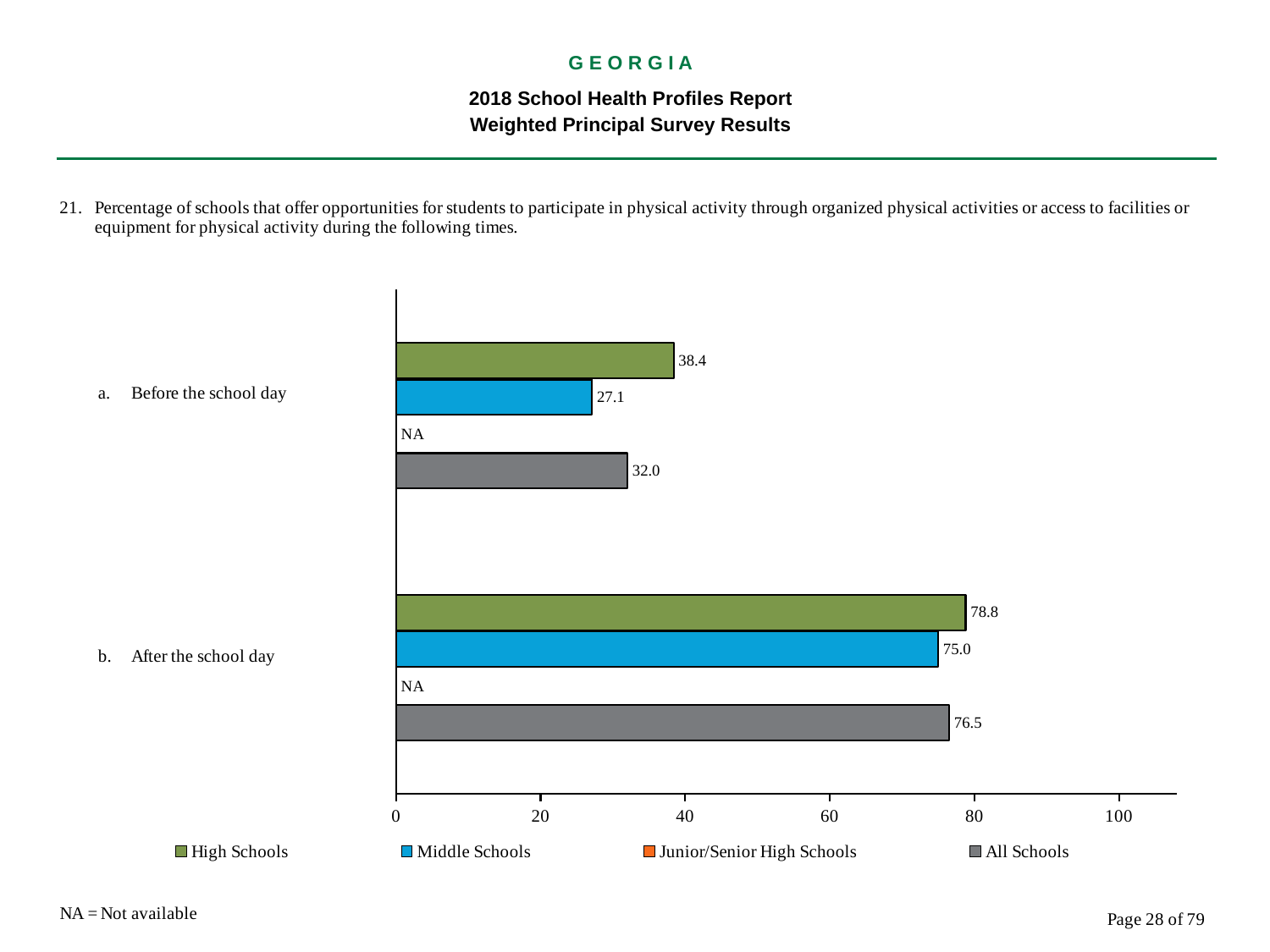
How many series does the legend list? 4 Which is larger for All Schools: 'Before the school day' or 'After the school day'? After the school day What is shown for Junior/Senior High Schools for 'After the school day'? NA Is the value for All Schools for 'After the school day' greater or less than 60? greater What is the value for All Schools for 'Before the school day'? 32.0 Which series has the lowest value for 'Before the school day' among those with a value shown? Middle Schools What is the value for Middle Schools for 'After the school day'? 75.0 What kind of chart is shown on the slide? Bar chart What is the value for High Schools for 'Before the school day'? 38.4 How many categories are shown on the chart? 2 What is the difference between the High Schools and Middle Schools values for 'Before the school day'? 11.3 Which series has the highest value for 'After the school day'? High Schools